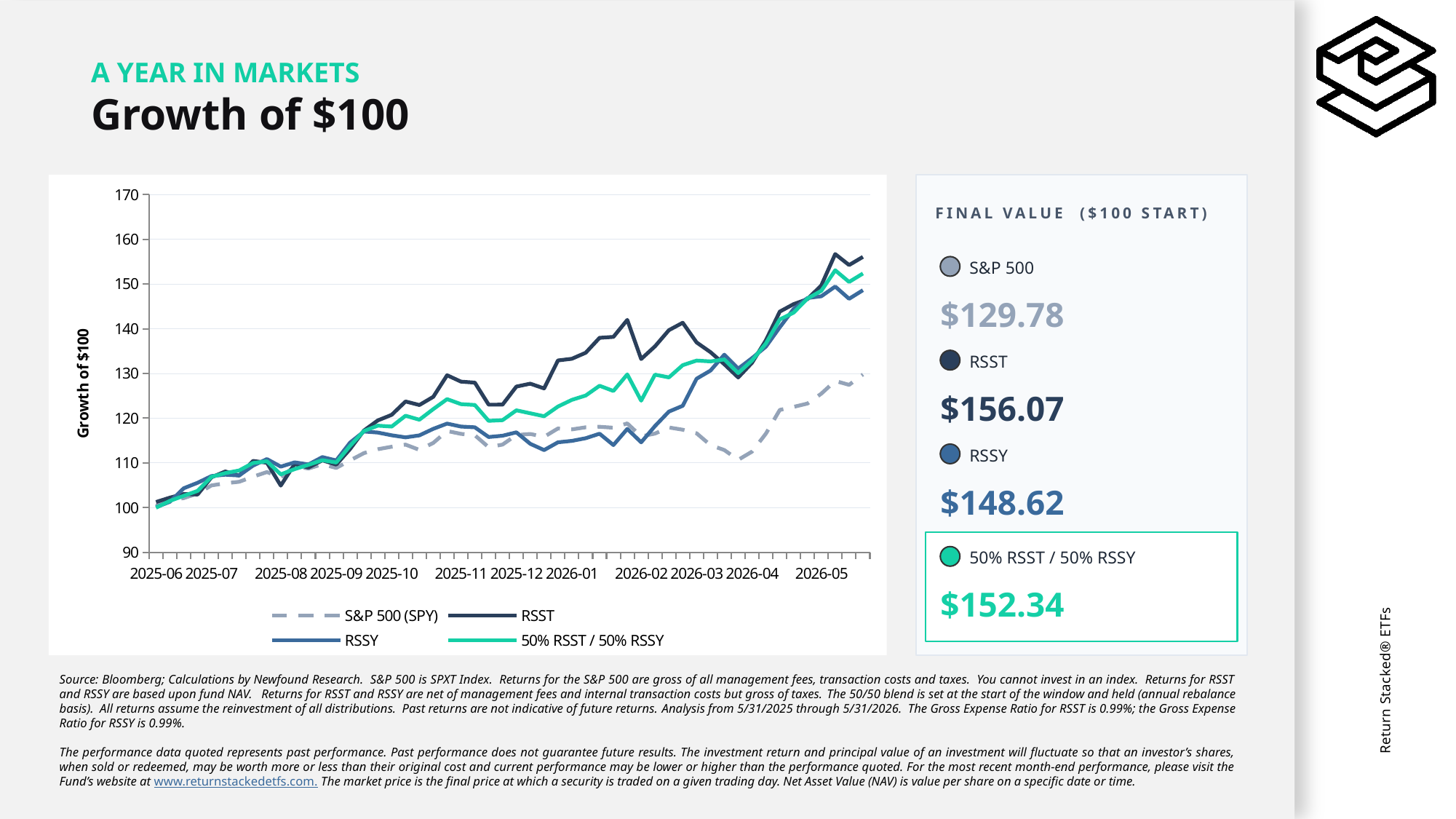
What kind of chart is shown on the slide? line chart What is the final value of RSST shown in the Final Value panel? $156.07 Which series has the highest final value? RSST Which series has the lowest final value? S&P 500 Do the lines generally rise or fall from 2025-06 to 2026-05? rise What is the final value of the 50% RSST / 50% RSSY blend? $152.34 What is the final value of the S&P 500 shown in the Final Value panel? $129.78 How many series does the chart's legend list? 4 Which has the larger final value, RSSY or the 50% RSST / 50% RSSY blend? 50% RSST / 50% RSSY What is the difference between the final values of RSST and the S&P 500? $26.29 What is the final value of RSSY shown in the Final Value panel? $148.62 Is the S&P 500 (SPY) line at 2026-04 greater or less than 120? less